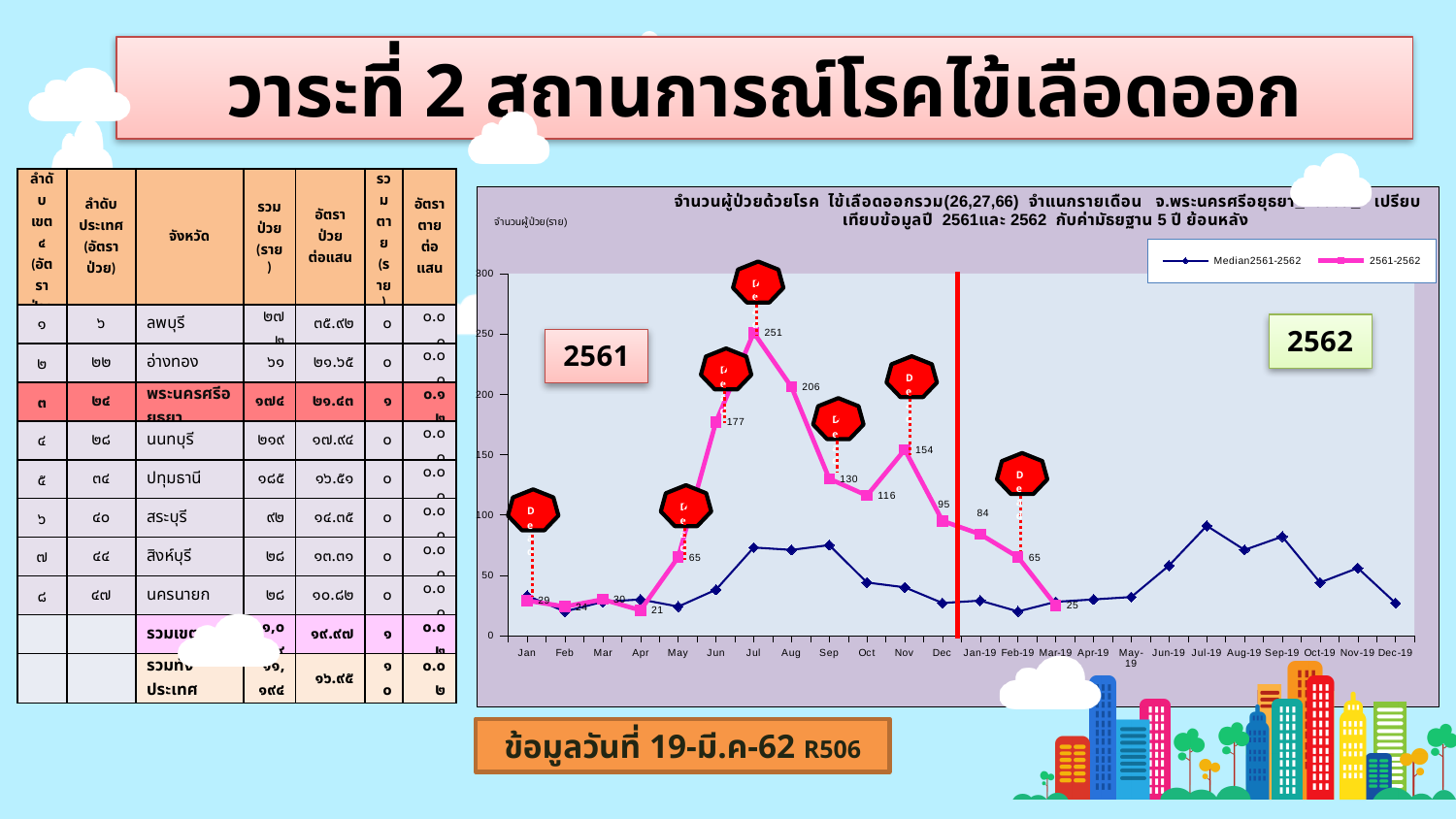
In which month does the 2561-2562 series reach its highest value? Jul Does the 2561-2562 series rise or fall from Apr to Jul? rise How many series does the chart legend list? 2 What are the two series named in the chart legend? Median2561-2562 and 2561-2562 What is the value of the 2561-2562 series in Mar-19? 25 Which is larger for the 2561-2562 series, the value in Jun or the value in Aug? Aug What is the difference between the 2561-2562 values in Aug and Sep? 76 What is the value of the 2561-2562 series in Jun? 177 What kind of chart is shown on the slide? line chart What is the value of the 2561-2562 series in Jul? 251 Is the value of the Median2561-2562 series in Jul-19 greater or less than 100? less What is the difference between the 2561-2562 values in Jul and Jun? 74